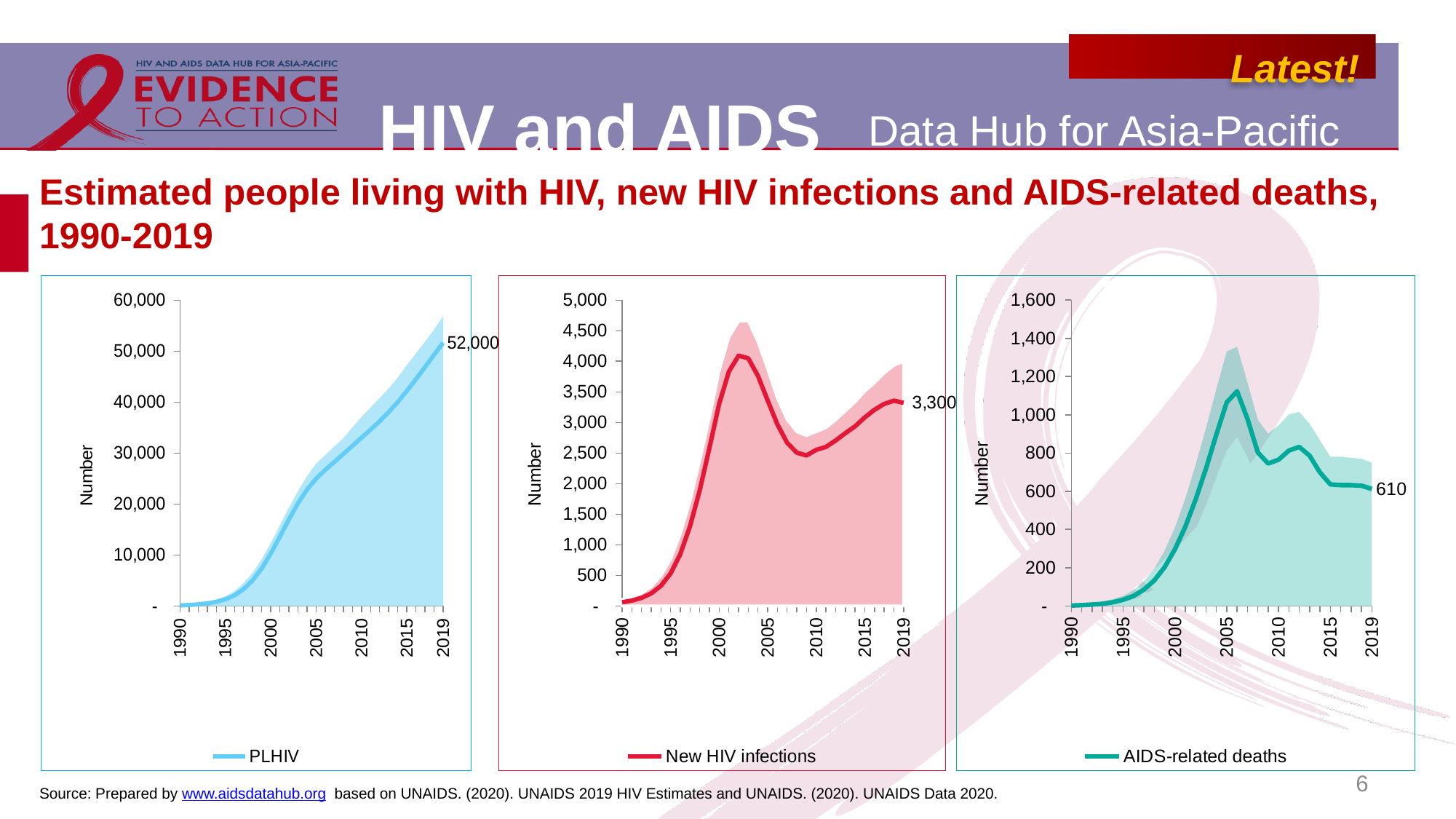
In the right chart (AIDS-related deaths), does the line rise or fall from 2010 to 2019? fall What is the legend entry of the middle chart? New HIV infections How many series does the legend of the right chart list? 1 In the middle chart (New HIV infections), what is the value labelled for 2019? 3,300 In the left chart (PLHIV), what is the value labelled for 2019? 52,000 In the middle chart (New HIV infections), is the value for 2019 greater or less than 3,000? greater In the left chart (PLHIV), is the value for 2005 greater or less than 30,000? less In the middle chart (New HIV infections), which year has the higher value, 2002 or 2009? 2002 In the right chart (AIDS-related deaths), what is the value labelled for 2019? 610 In the right chart (AIDS-related deaths), is the value for 2005 greater or less than 800? greater In the left chart (PLHIV), does the line rise or fall from 1990 to 2019? rise What type of chart is the left chart (PLHIV)? line chart